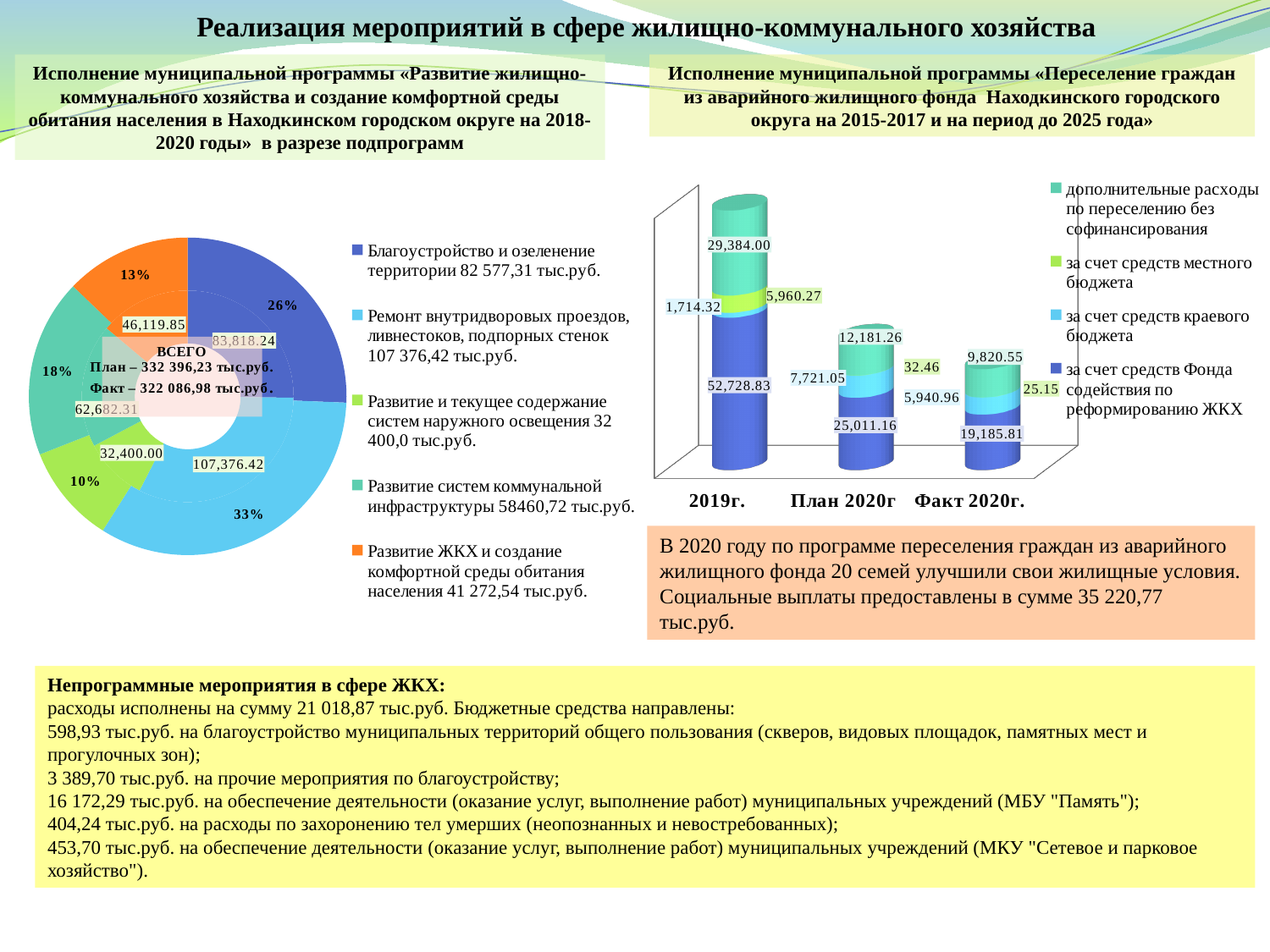
In the chart on the right, what is the value for «за счет средств Фонда содействия по реформированию ЖКХ» in Факт 2020г.? 19,185.81 In the chart on the right, what is the value for «дополнительные расходы по переселению без софинансирования» in 2019г.? 29,384.00 What kind of chart is the chart on the right of the slide (under the «Переселение граждан из аварийного жилищного фонда» heading)? bar chart In the chart on the right, how many categories are shown on the x axis? 3 In the chart on the right, what is the difference between the «за счет средств Фонда содействия по реформированию ЖКХ» values for План 2020г and Факт 2020г.? 5,825.35 In the doughnut chart on the left, how many subprograms (slices) are shown? 5 In the doughnut chart on the left, what total plan amount («План») is shown in the centre of the chart? 332 396,23 тыс.руб. In the chart on the right, what is the value for «за счет средств Фонда содействия по реформированию ЖКХ» in 2019г.? 52,728.83 In the chart on the right, how many series does the legend list? 4 In the doughnut chart on the left, what share does «Ремонт внутридворовых проездов, ливнестоков, подпорных стенок» have? 33% In the doughnut chart on the left, which subprogram has the smallest share? Развитие и текущее содержание систем наружного освещения In the chart on the right, which category has the highest value for «за счет средств Фонда содействия по реформированию ЖКХ»? 2019г.